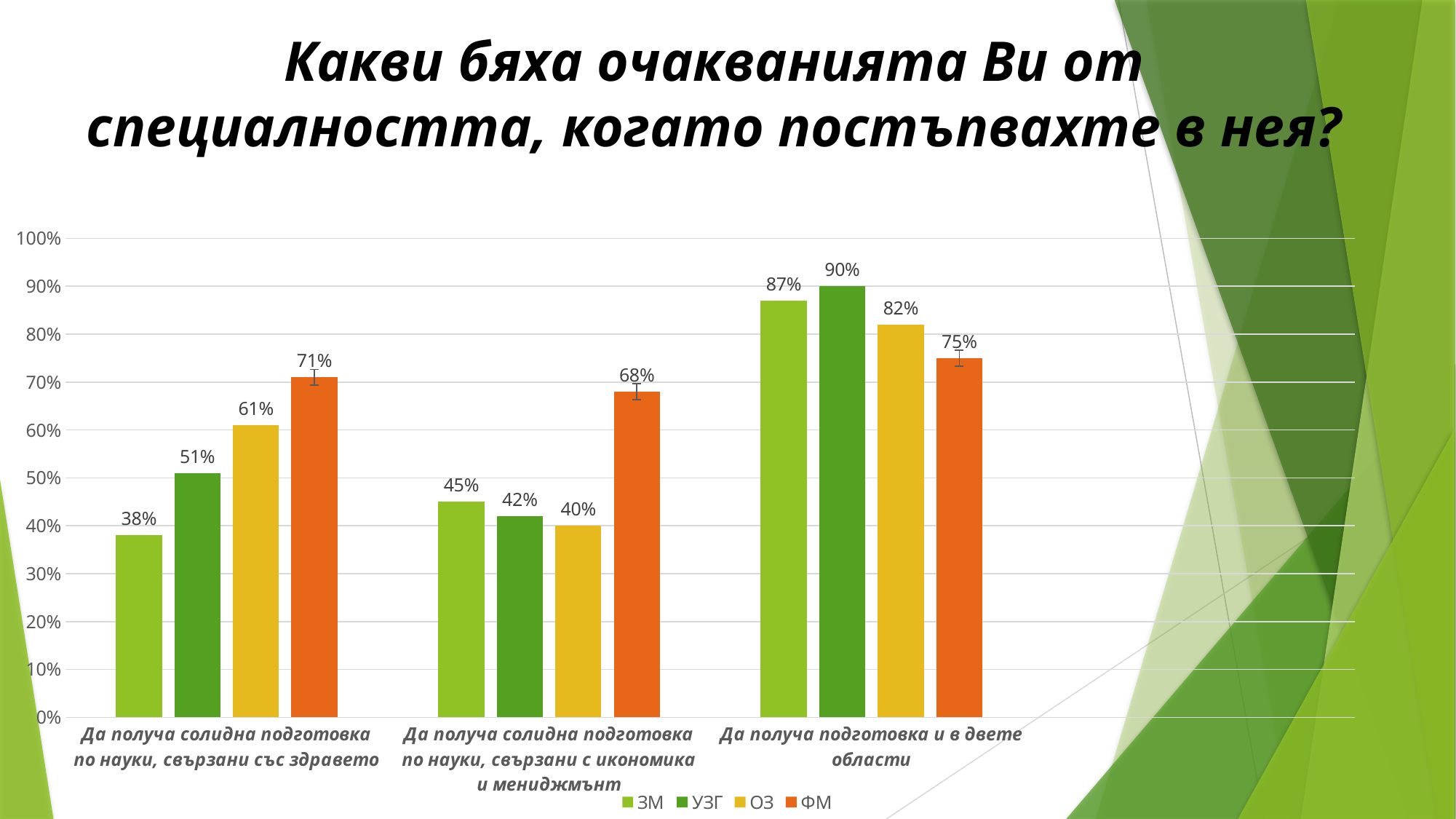
Which series has the highest value in the category "Да получа подготовка и в двете области"? УЗГ How many series does the legend list? 4 Which series is shown in orange in the legend? ФМ Which is larger in the category "Да получа солидна подготовка по науки, свързани с икономика и мениджмънт": the value for ЗМ or the value for ФМ? ФМ What kind of chart is shown on the slide? Bar chart How many categories are shown on the x axis? 3 What is the value for ФМ in the category "Да получа солидна подготовка по науки, свързани със здравето"? 71% What is the value for ЗМ in the category "Да получа подготовка и в двете области"? 87% What is the difference between the УЗГ and ОЗ values in the category "Да получа подготовка и в двете области"? 8% What is the difference between the ФМ and ЗМ values in the category "Да получа солидна подготовка по науки, свързани със здравето"? 33% Which series has the lowest value in the category "Да получа солидна подготовка по науки, свързани със здравето"? ЗМ What is the value for ОЗ in the category "Да получа солидна подготовка по науки, свързани с икономика и мениджмънт"? 40%